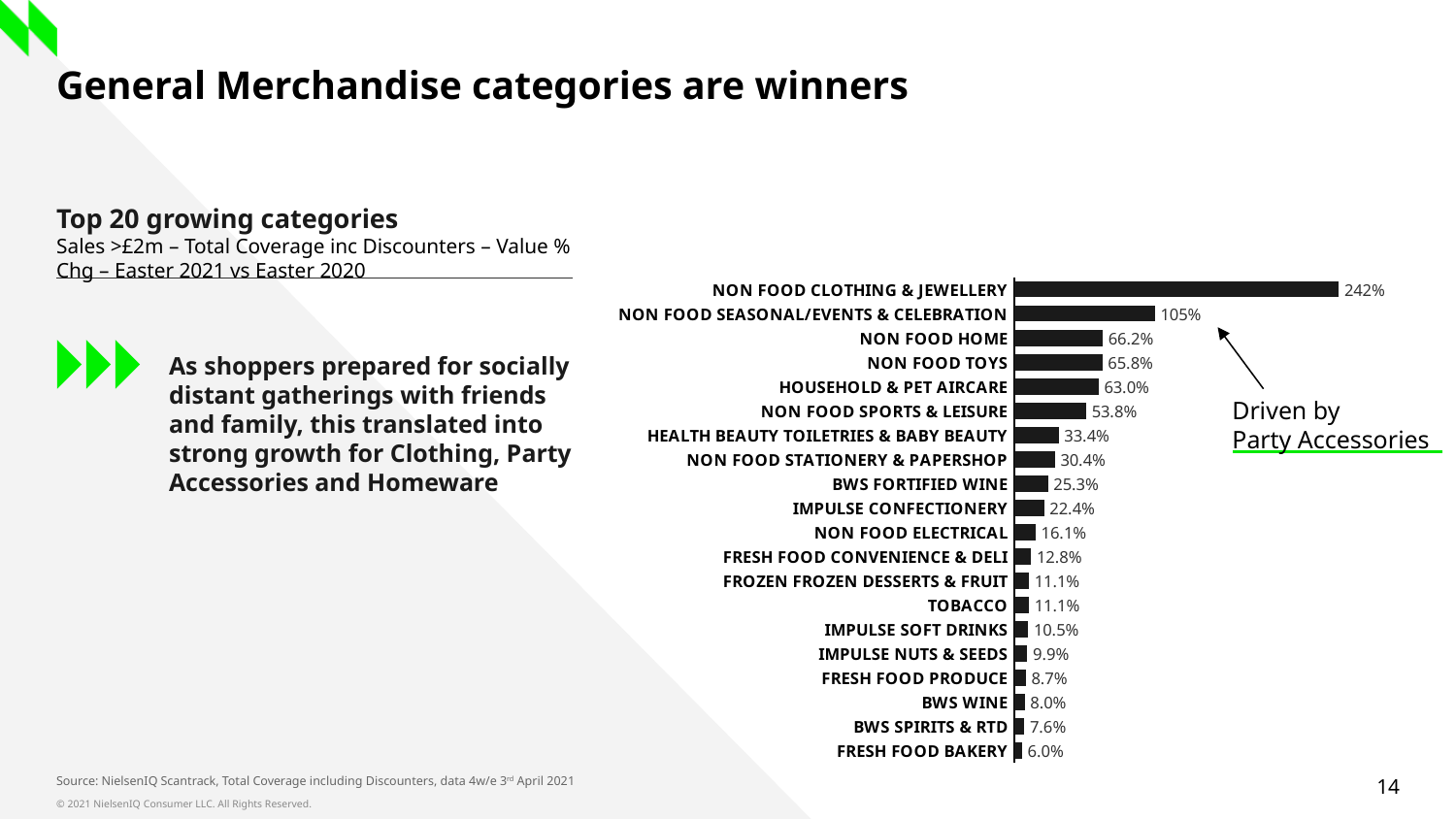
What is the value for FRESH FOOD BAKERY? 6.0% What is the value for BWS FORTIFIED WINE? 25.3% What is the difference between the values for NON FOOD CLOTHING & JEWELLERY and NON FOOD SEASONAL/EVENTS & CELEBRATION? 137% Which category has the lowest value? FRESH FOOD BAKERY What is the difference between the values for NON FOOD HOME and NON FOOD TOYS? 0.4% What is the value for HOUSEHOLD & PET AIRCARE? 63.0% According to the annotation, what is the growth in NON FOOD SEASONAL/EVENTS & CELEBRATION driven by? Party Accessories Which category has the highest value? NON FOOD CLOTHING & JEWELLERY Which is larger, the value for IMPULSE CONFECTIONERY or the value for NON FOOD ELECTRICAL? IMPULSE CONFECTIONERY What kind of chart is shown on the slide? Bar chart How many categories are shown in the chart? 20 What is the value for NON FOOD CLOTHING & JEWELLERY? 242%